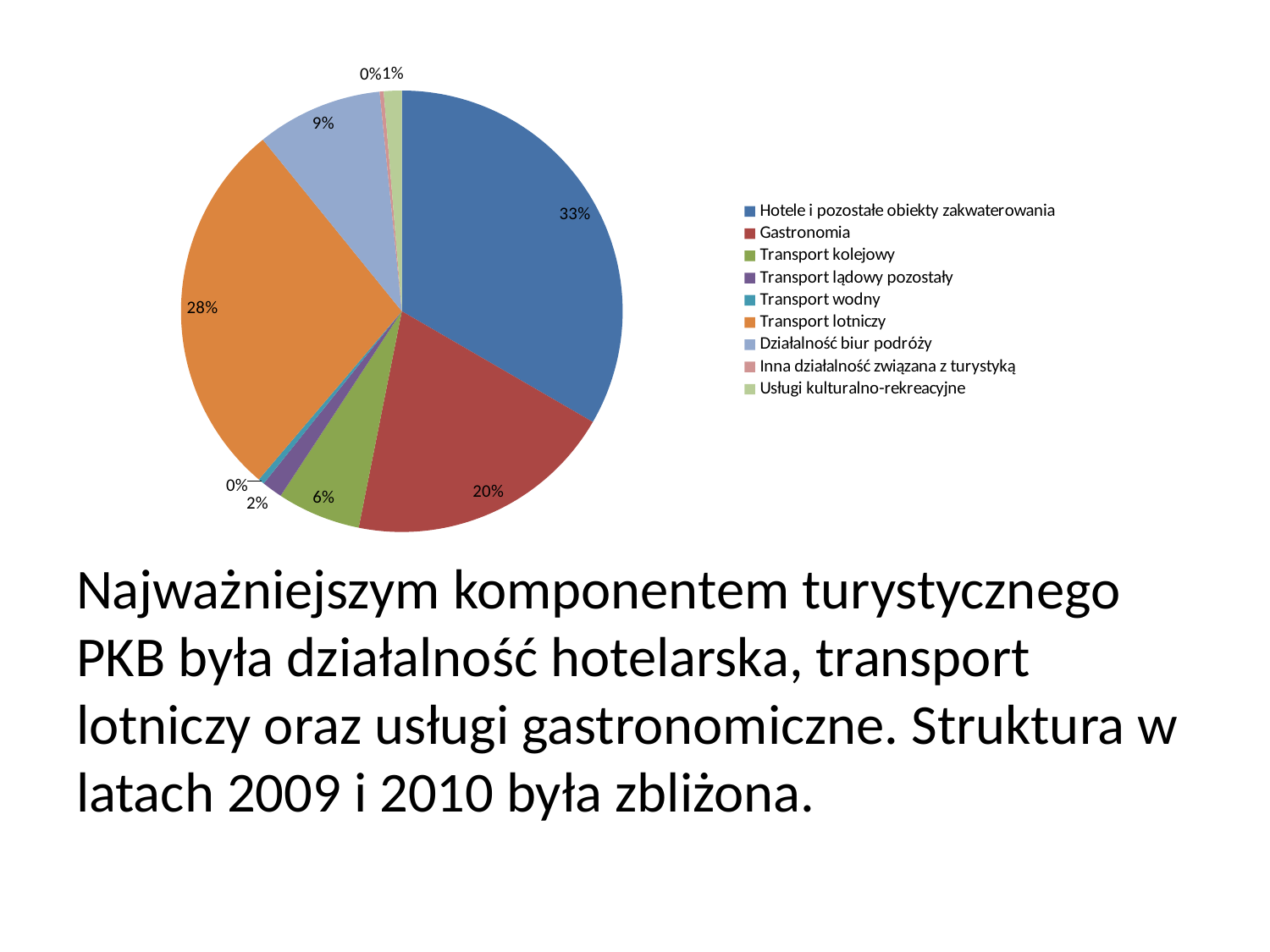
What is the difference in percentage points between the shares of "Hotele i pozostałe obiekty zakwaterowania" and "Transport lotniczy"? 5 percentage points What type of chart is shown on the slide? pie chart What colour is the slice for "Transport lotniczy"? orange What share of the pie does "Działalność biur podróży" have? 9% What share of the pie does "Transport kolejowy" have? 6% What share of the pie does "Transport lotniczy" have? 28% Which category has the largest slice of the pie? Hotele i pozostałe obiekty zakwaterowania Which has a larger share, "Gastronomia" or "Działalność biur podróży"? Gastronomia How many categories does the legend list? 9